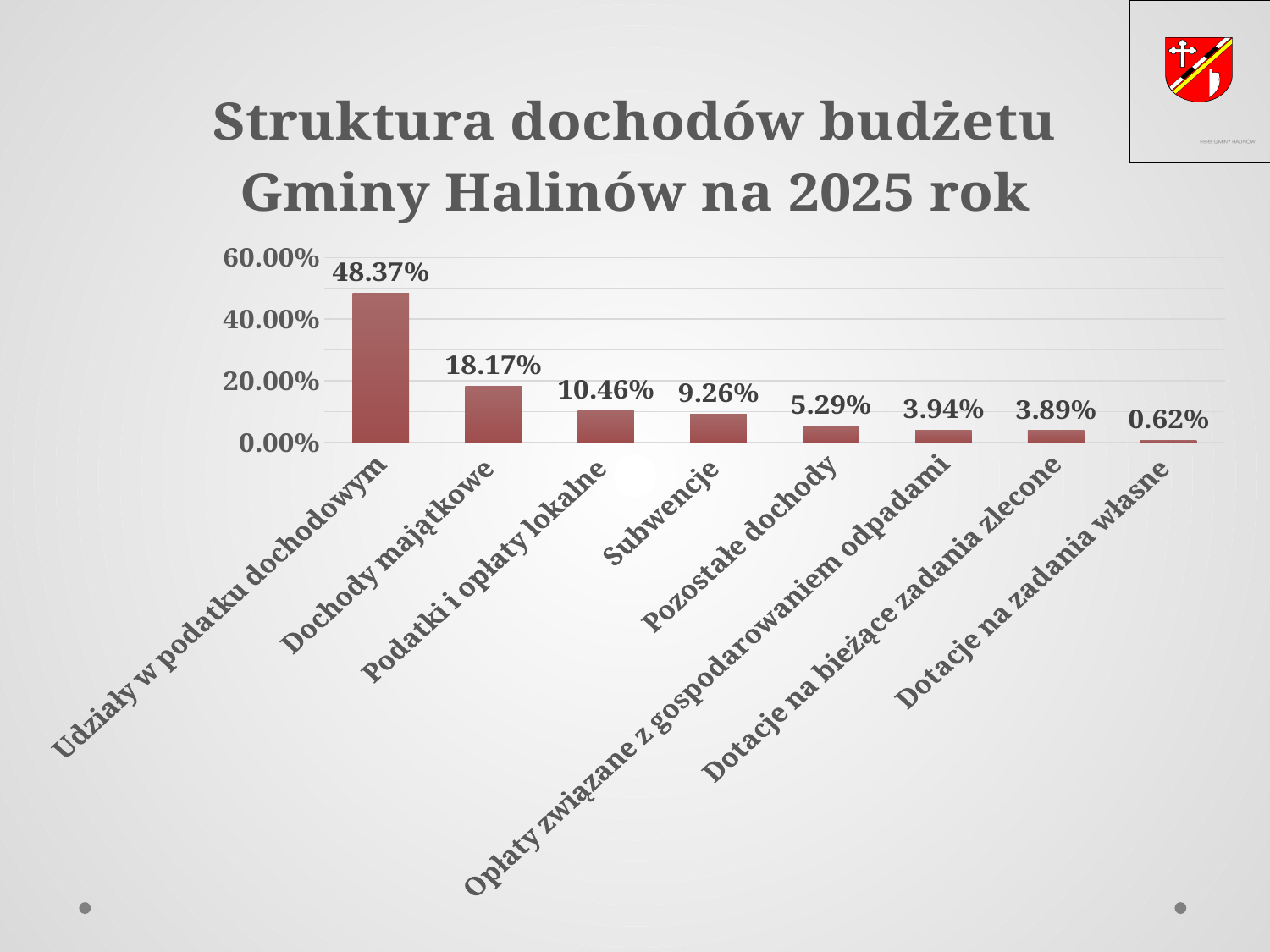
Which is larger, Podatki i opłaty lokalne or Subwencje? Podatki i opłaty lokalne Is the value for Dochody majątkowe greater or less than 20.00%? less How many categories are shown in the chart? 8 What kind of chart is shown on the slide? bar chart What is the value for Dochody majątkowe? 18.17% What is the value for Subwencje? 9.26% Which category has the lowest value? Dotacje na zadania własne What is the title of the chart on the slide? Struktura dochodów budżetu Gminy Halinów na 2025 rok What is the value for Udziały w podatku dochodowym? 48.37% What is the difference between Udziały w podatku dochodowym and Dochody majątkowe? 30.20% Which category has the highest value? Udziały w podatku dochodowym What is the value for Dotacje na zadania własne? 0.62%